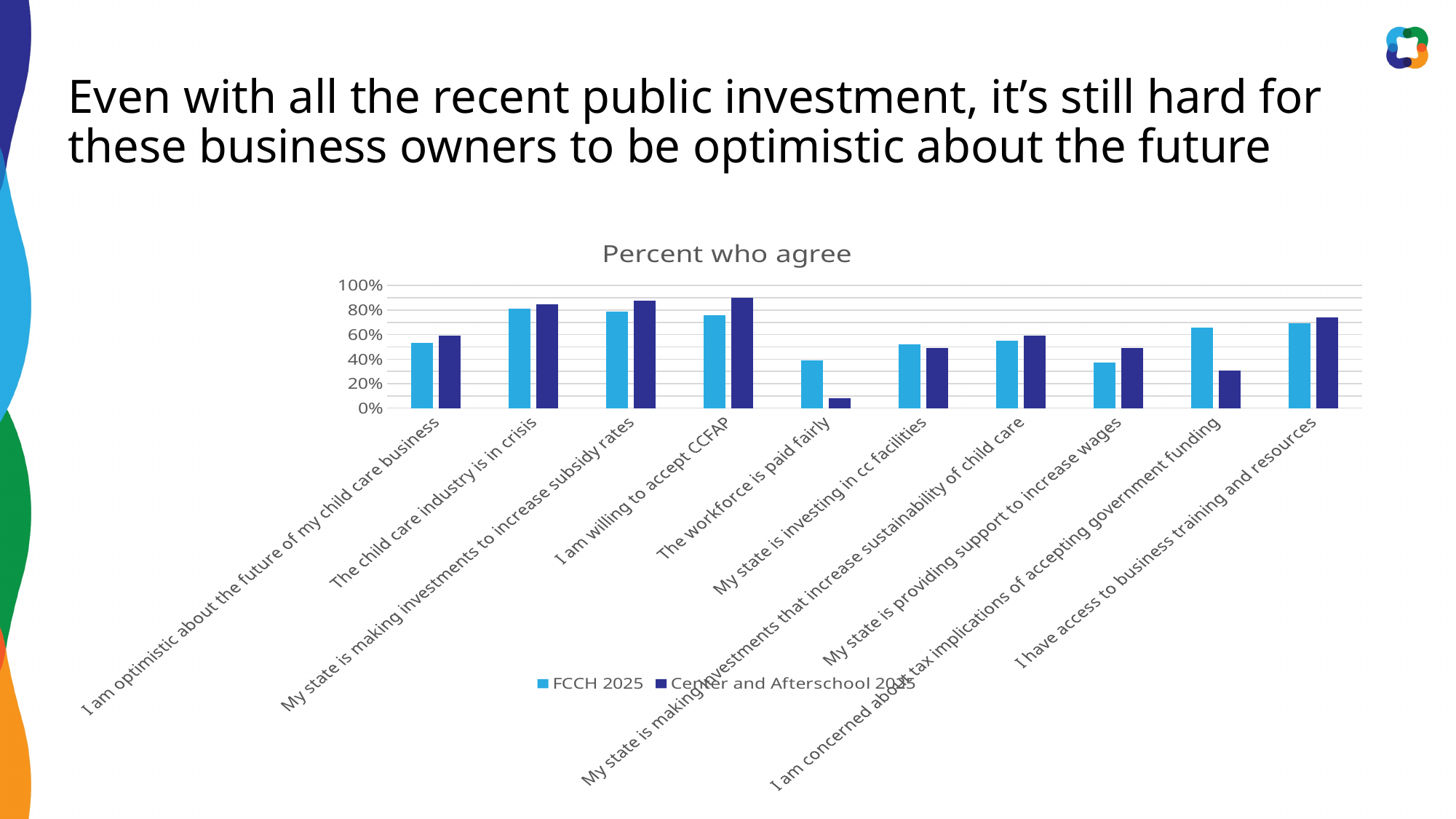
For "I am willing to accept CCFAP", which series has the larger value, FCCH 2025 or Center and Afterschool 2025? Center and Afterschool 2025 Is the FCCH 2025 value for "My state is providing support to increase wages" greater or less than 50%? less What is the title of the chart? Percent who agree For "The workforce is paid fairly", which series has the larger value, FCCH 2025 or Center and Afterschool 2025? FCCH 2025 How many series does the legend list? 2 What kind of chart is shown on the slide? bar chart Which series has the lowest value for "The workforce is paid fairly"? Center and Afterschool 2025 Is the Center and Afterschool 2025 value for "The workforce is paid fairly" greater or less than 20%? less Which category has the lowest Center and Afterschool 2025 value? The workforce is paid fairly How many statement categories are shown on the x axis? 10 Is the Center and Afterschool 2025 value for "I am willing to accept CCFAP" greater or less than 80%? greater For "I am concerned about tax implications of accepting government funding", which series has the larger value? FCCH 2025